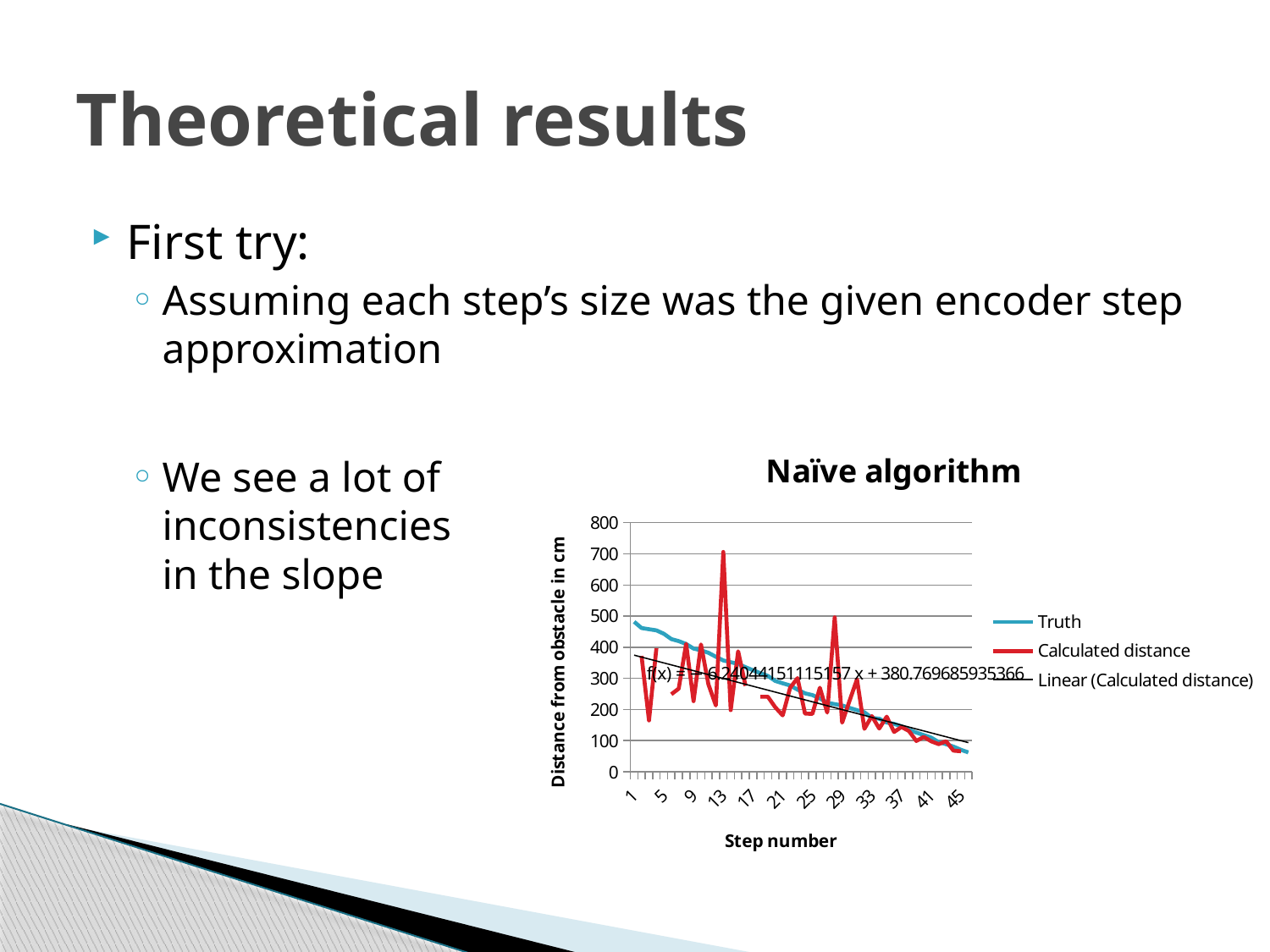
Is the highest peak of the Calculated distance series greater or less than 600? greater Is the Truth value at step 45 greater or less than 100? less How many series does the legend of the chart list? 3 Does the Truth series rise or fall as the step number increases? fall Which series has the highest single value on the chart? Calculated distance What is the title of the chart? Naïve algorithm What kind of chart is shown on the slide? line chart What is the label of the y axis of the chart? Distance from obstacle in cm Is the Truth value at step 1 greater or less than 400? greater Which series shows the larger value at step 13, Truth or Calculated distance? Calculated distance